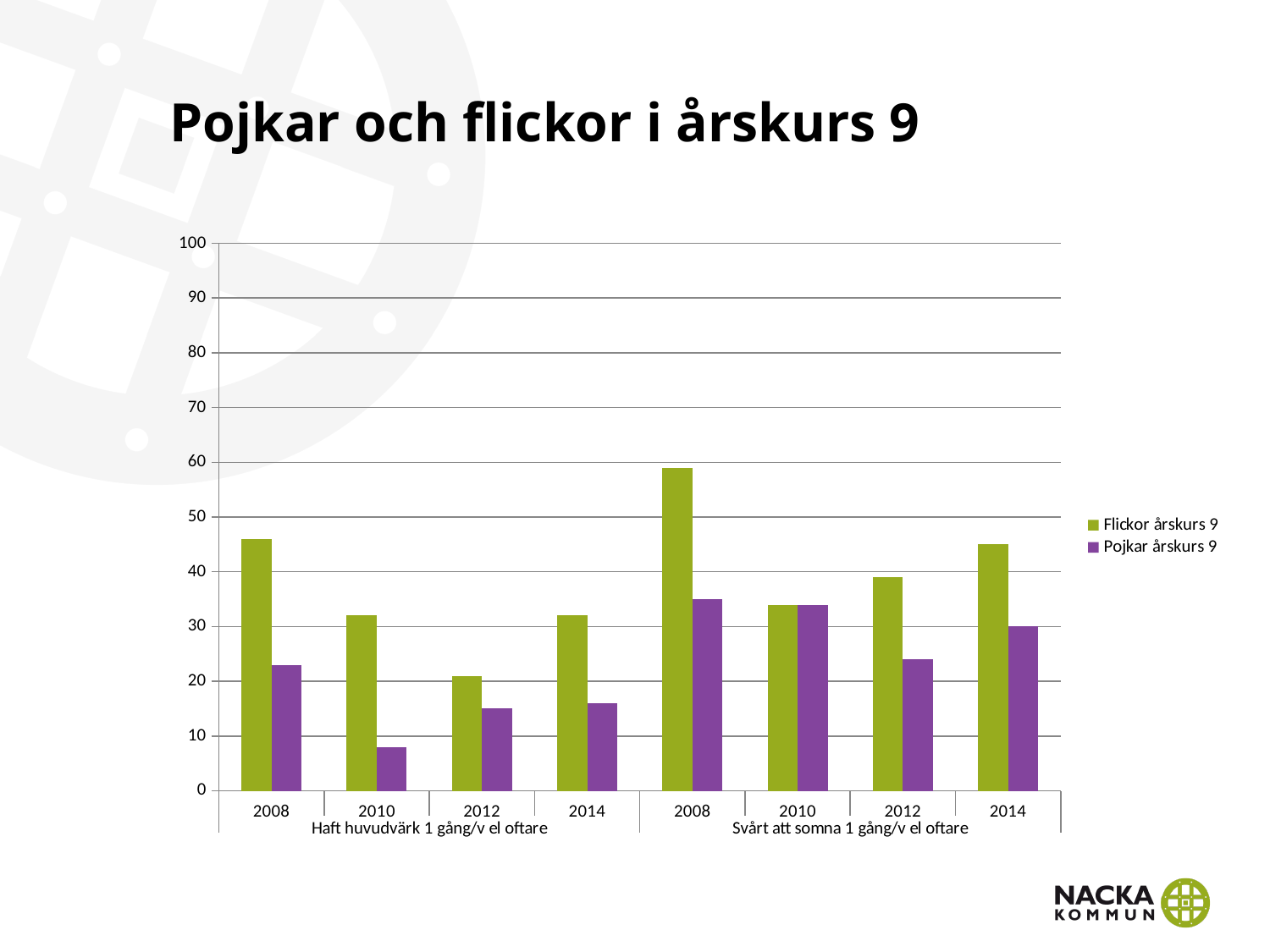
How many series does the legend list? 2 In which year and group is the Pojkar årskurs 9 bar lowest? 2010, Haft huvudvärk 1 gång/v el oftare What are the two series named in the legend? Flickor årskurs 9 and Pojkar årskurs 9 How many year categories are shown along the x axis in total? 8 In which year and group is the Flickor årskurs 9 bar highest? 2008, Svårt att somna 1 gång/v el oftare What colour are the Pojkar årskurs 9 bars? Purple What kind of chart is shown on the slide? Bar chart Is the Pojkar årskurs 9 value for 2010 under Haft huvudvärk 1 gång/v el oftare greater or less than 10? less For 2008 under Haft huvudvärk 1 gång/v el oftare, which series has the larger value, Flickor årskurs 9 or Pojkar årskurs 9? Flickor årskurs 9 Is the Flickor årskurs 9 value for 2008 under Svårt att somna 1 gång/v el oftare greater or less than 50? greater Is the Flickor årskurs 9 value for 2008 under Haft huvudvärk 1 gång/v el oftare greater or less than 40? greater For 2012 under Svårt att somna 1 gång/v el oftare, which series has the larger value, Flickor årskurs 9 or Pojkar årskurs 9? Flickor årskurs 9